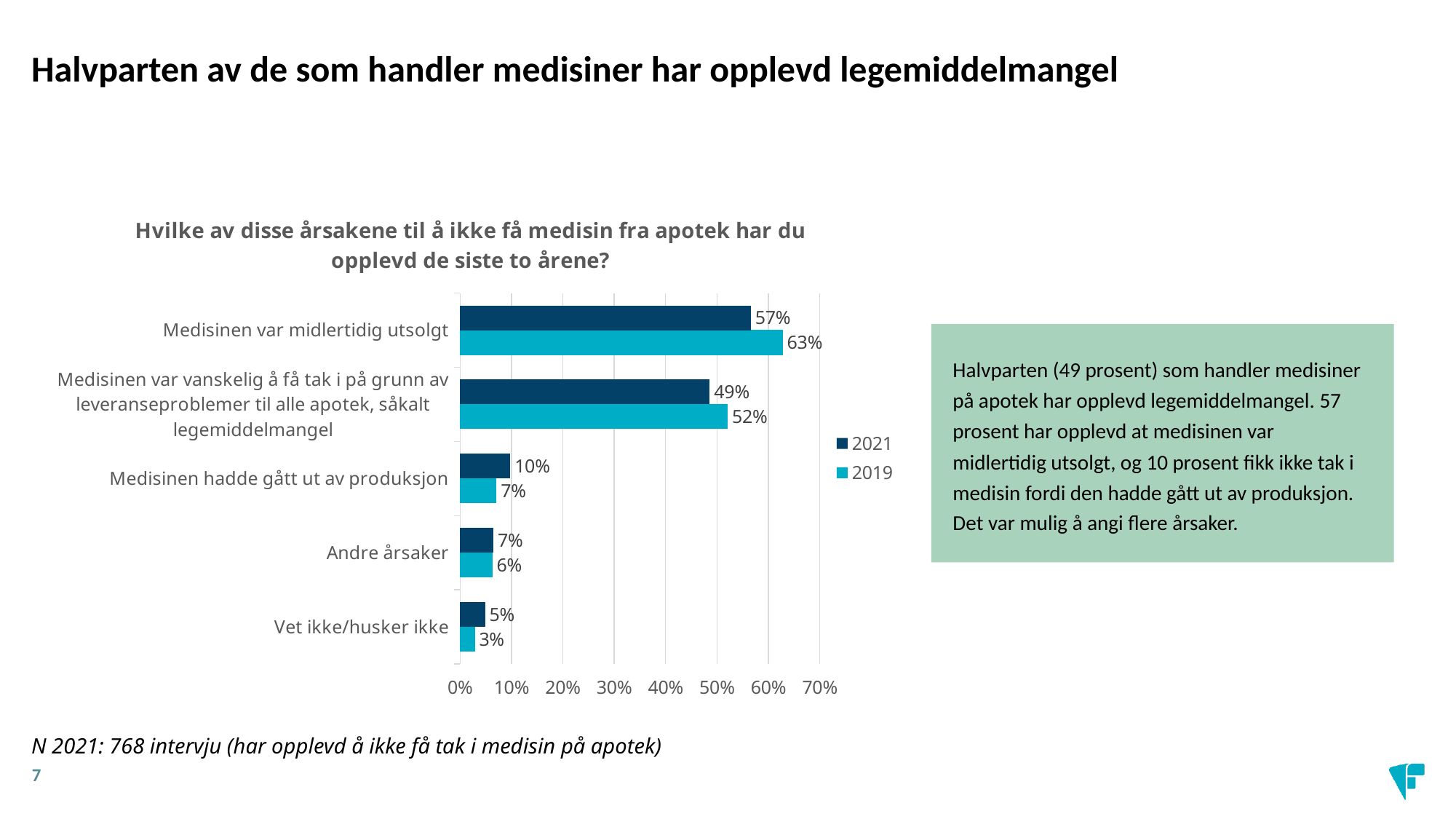
Which category has the lowest 2021 value? Vet ikke/husker ikke Which category has the highest 2019 value? Medisinen var midlertidig utsolgt How many categories are shown on the chart? 5 For "Andre årsaker", which year has the larger value, 2021 or 2019? 2021 What is the 2021 value for "Medisinen var midlertidig utsolgt"? 57% How many series does the legend list? 2 What is the 2019 value for "Vet ikke/husker ikke"? 3% What is the difference between the 2019 and 2021 values for "Medisinen var midlertidig utsolgt"? 6 percentage points Is the 2019 value for "Medisinen var vanskelig å få tak i på grunn av leveranseproblemer til alle apotek, såkalt legemiddelmangel" greater or less than 50%? greater What kind of chart is shown on the slide? Bar chart What is the maximum value shown on the x axis? 70% What is the 2019 value for "Medisinen hadde gått ut av produksjon"? 7%